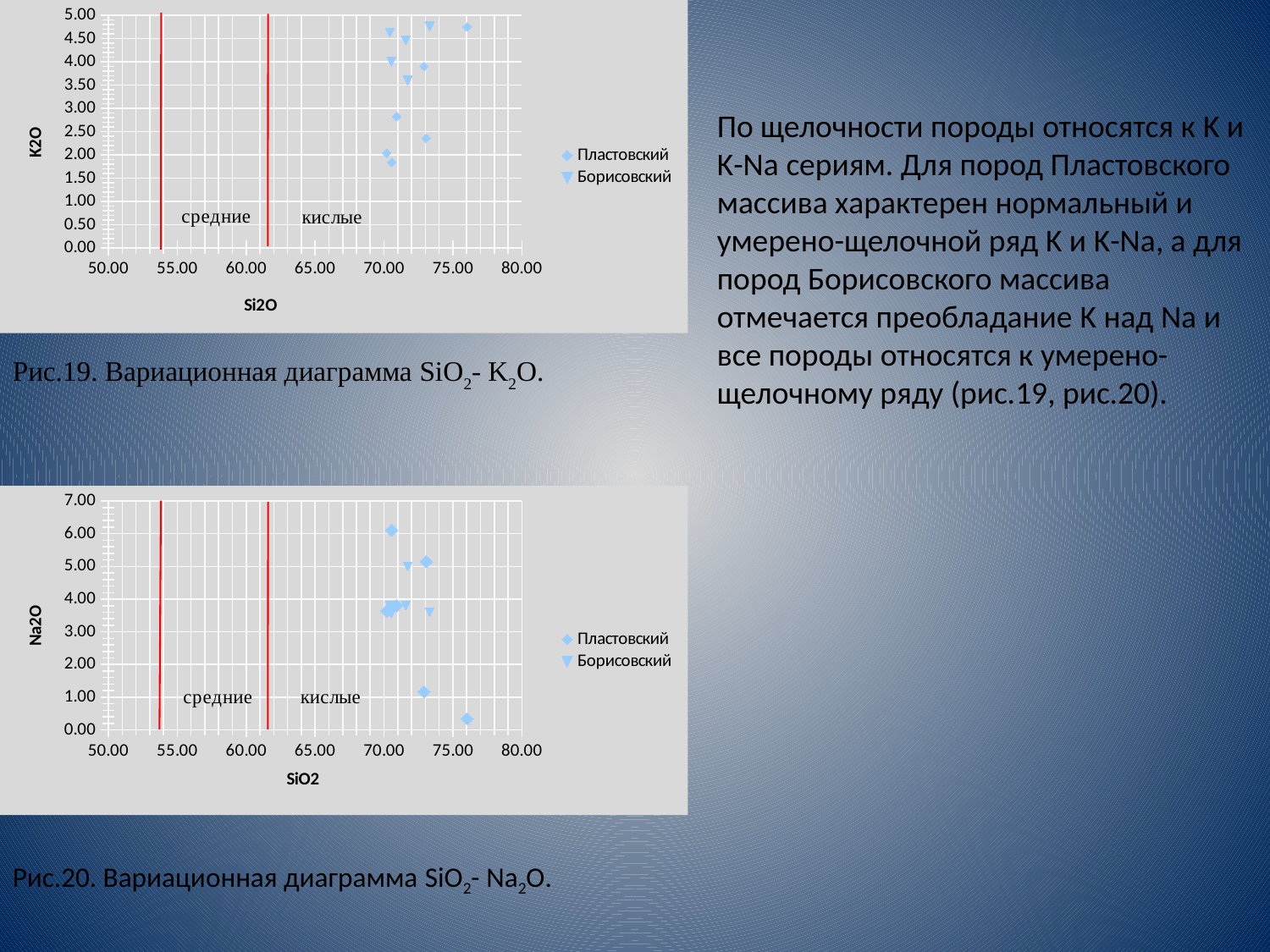
What kind of chart is the top chart (Рис.19)? scatter chart What is the y-axis title of the bottom chart? Na2O In the top chart (K2O vs Si2O), is the highest K2O value of the Борисовский series greater or less than 4.00? greater In the bottom chart (Na2O vs SiO2), is the highest Na2O value of the Пластовский series greater or less than 5.00? greater In the top chart (K2O vs Si2O), is the lowest K2O value of the Пластовский series greater or less than 1.50? greater How many series does the legend of the top chart (K2O vs Si2O) list? 2 What kind of chart is the bottom chart (Рис.20)? scatter chart In the top chart (K2O vs Si2O), what are the two series named in the legend? Пластовский, Борисовский How many series does the legend of the bottom chart (Na2O vs SiO2) list? 2